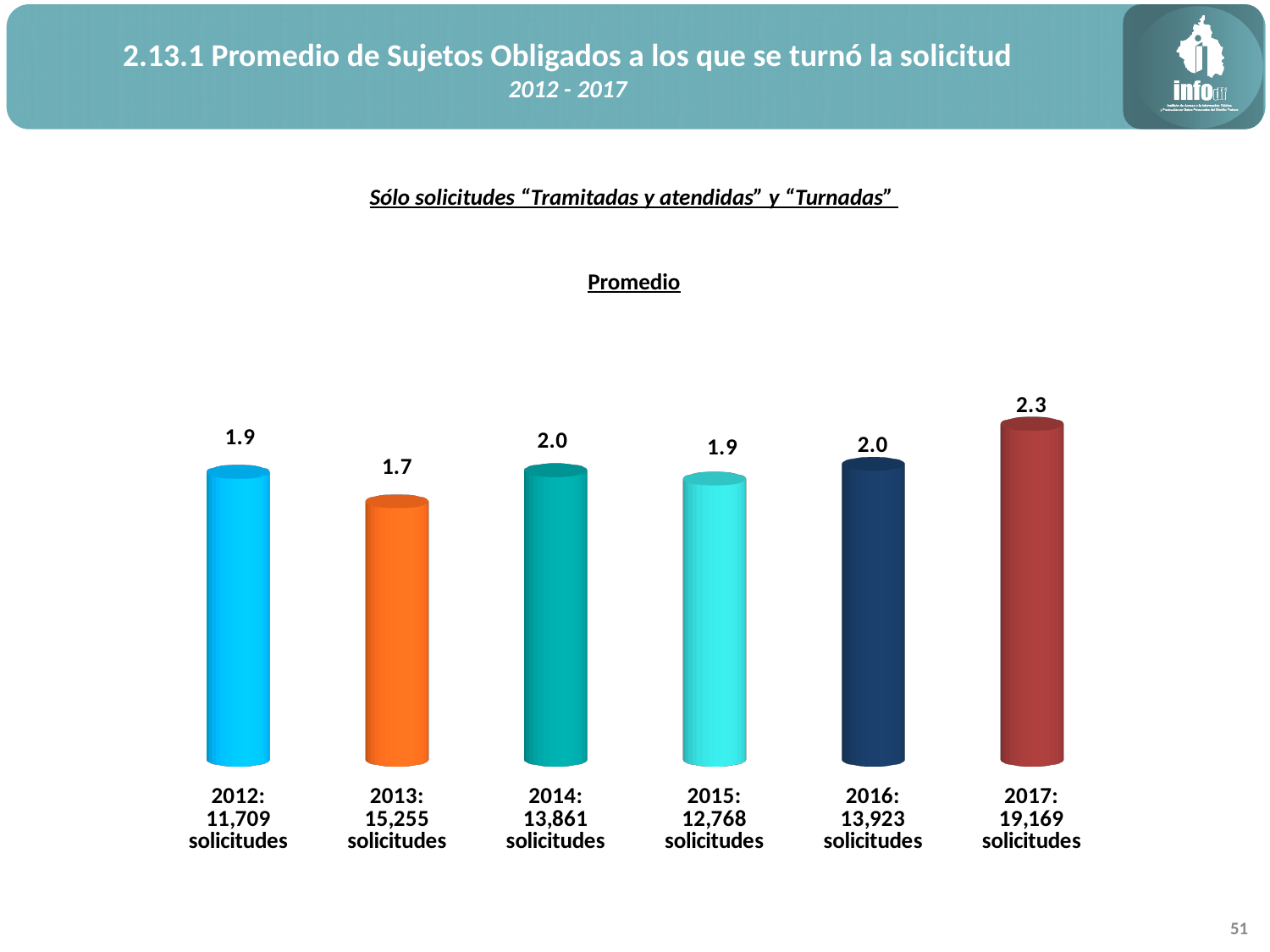
Which year has the lowest average value? 2013 Which year has the highest average value? 2017 How many solicitudes are listed under the 2016 bar label? 13,923 How many years (bars) are shown in the chart? 6 What is the title of the chart? Promedio What is the average value shown for 2013? 1.7 How many solicitudes are listed under the 2017 bar label? 19,169 Which is larger, the average value for 2014 or for 2013? 2014 What is the average value shown for 2017? 2.3 What is the difference between the average values for 2017 and 2013? 0.6 What is the average (Promedio) value shown for 2012? 1.9 What kind of chart is shown on the slide? Bar chart